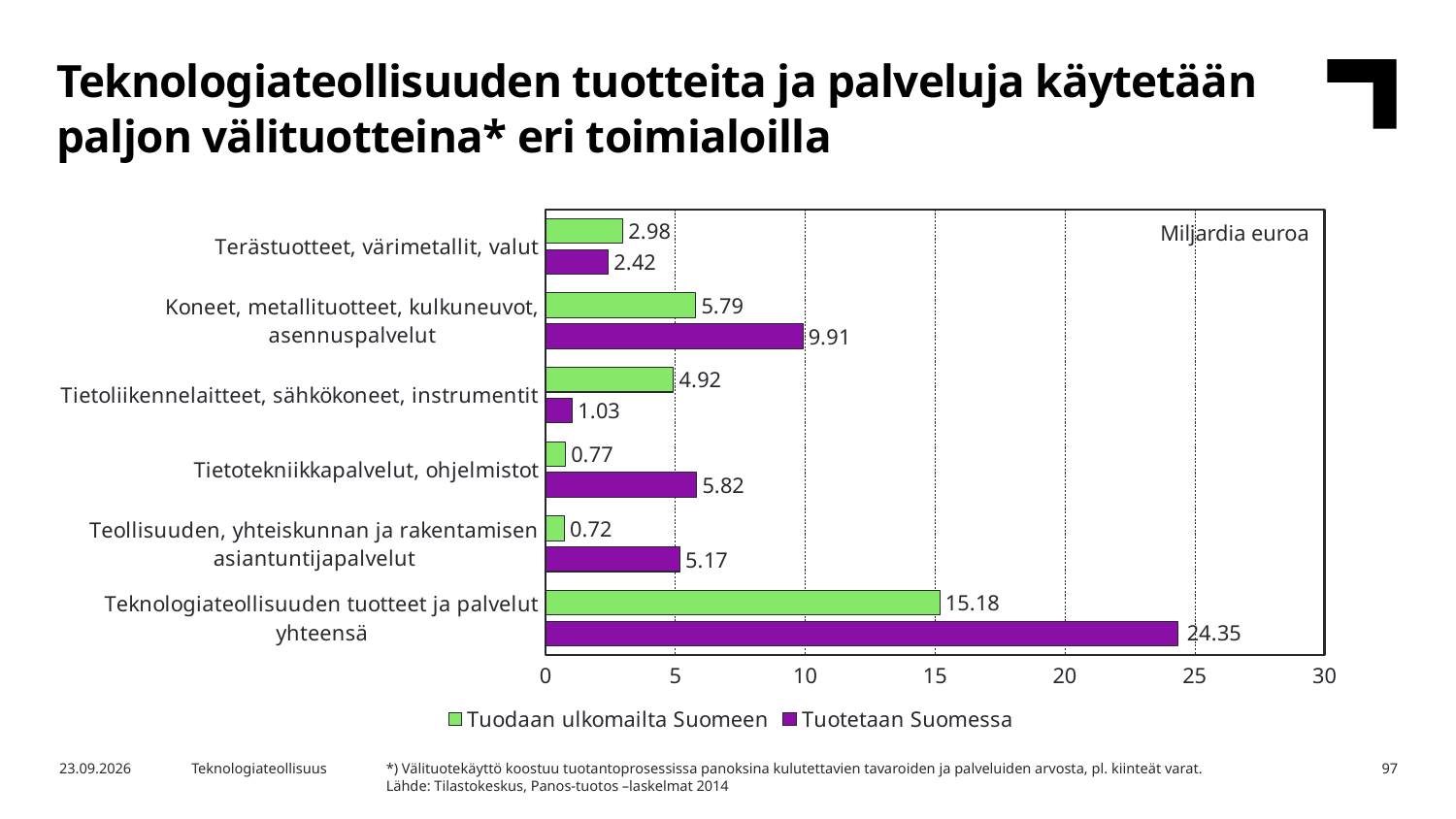
What is the difference between "Tuotetaan Suomessa" and "Tuodaan ulkomailta Suomeen" for "Tietotekniikkapalvelut, ohjelmistot"? 5.05 How many categories are shown on the chart? 6 What unit is indicated in the top right corner of the chart? Miljardia euroa Excluding the total row, which category has the highest value for "Tuotetaan Suomessa"? Koneet, metallituotteet, kulkuneuvot, asennuspalvelut Which category has the lowest value for "Tuodaan ulkomailta Suomeen"? Teollisuuden, yhteiskunnan ja rakentamisen asiantuntijapalvelut What is the value for "Tuodaan ulkomailta Suomeen" in the category "Tietoliikennelaitteet, sähkökoneet, instrumentit"? 4.92 Is the value for "Tuotetaan Suomessa" in "Teknologiateollisuuden tuotteet ja palvelut yhteensä" greater or less than 20? greater For "Terästuotteet, värimetallit, valut", which is larger: "Tuodaan ulkomailta Suomeen" or "Tuotetaan Suomessa"? Tuodaan ulkomailta Suomeen What kind of chart is shown on the slide? Bar chart What is the value for "Tuotetaan Suomessa" in the category "Koneet, metallituotteet, kulkuneuvot, asennuspalvelut"? 9.91 What is the value for "Tuotetaan Suomessa" in the category "Teknologiateollisuuden tuotteet ja palvelut yhteensä"? 24.35 How many series does the legend list? 2